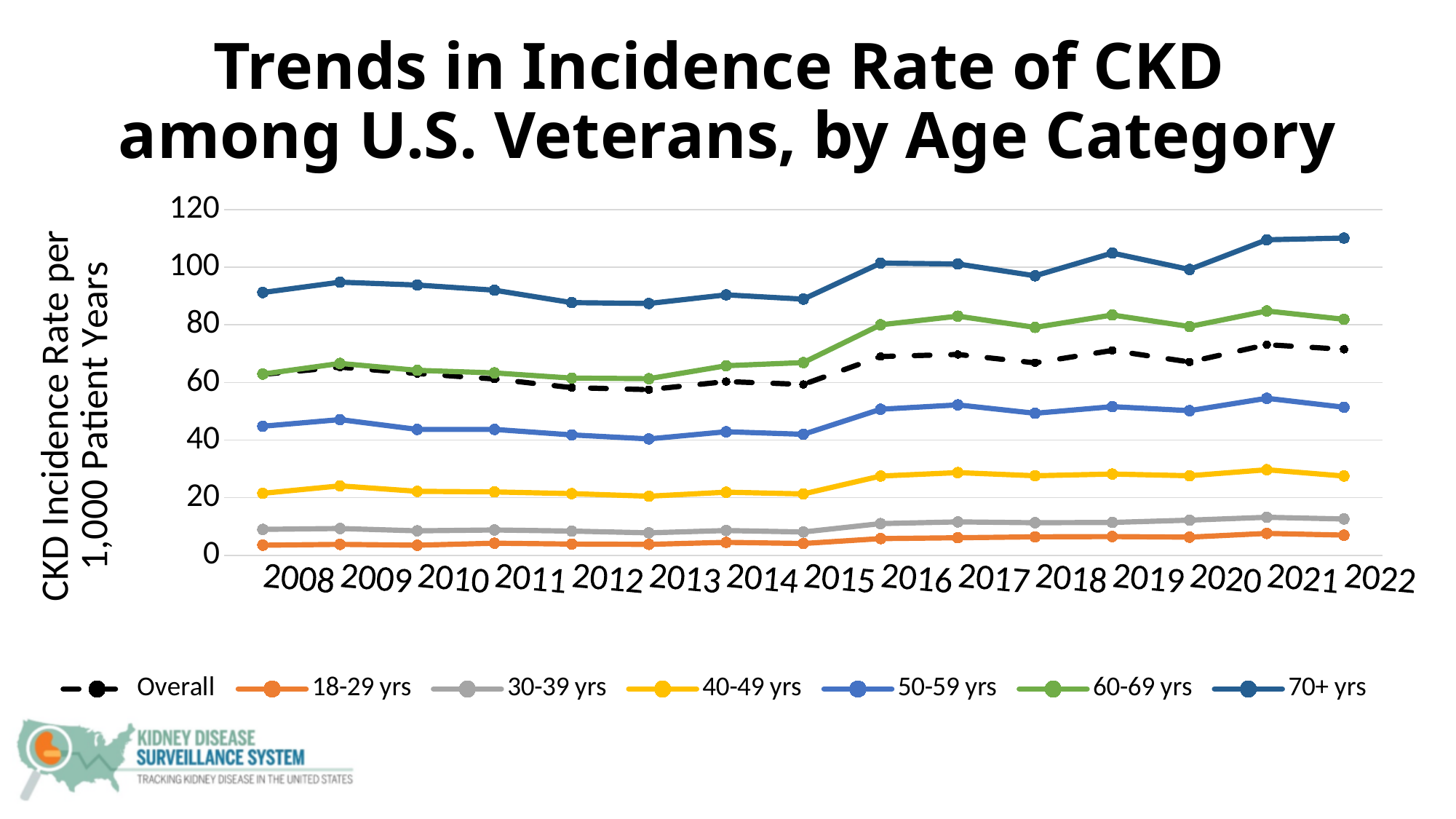
Which age category has the lowest CKD incidence rate across all years? 18-29 yrs Which series is drawn with a dashed line? Overall Is the value for 70+ yrs in 2022 greater or less than 100? greater Is the value for Overall in 2016 greater or less than 60? greater How many years are plotted along the x axis? 15 What is the label on the y axis? CKD Incidence Rate per 1,000 Patient Years Which age category has the highest CKD incidence rate across all years? 70+ yrs How many series does the legend list? 7 Is the value for 60-69 yrs in 2012 greater or less than 80? less In 2022, which is larger: the value for 50-59 yrs or the value for 40-49 yrs? 50-59 yrs What kind of chart is shown on the slide? line chart Does the Overall CKD incidence rate rise or fall between 2014 and 2016? rise